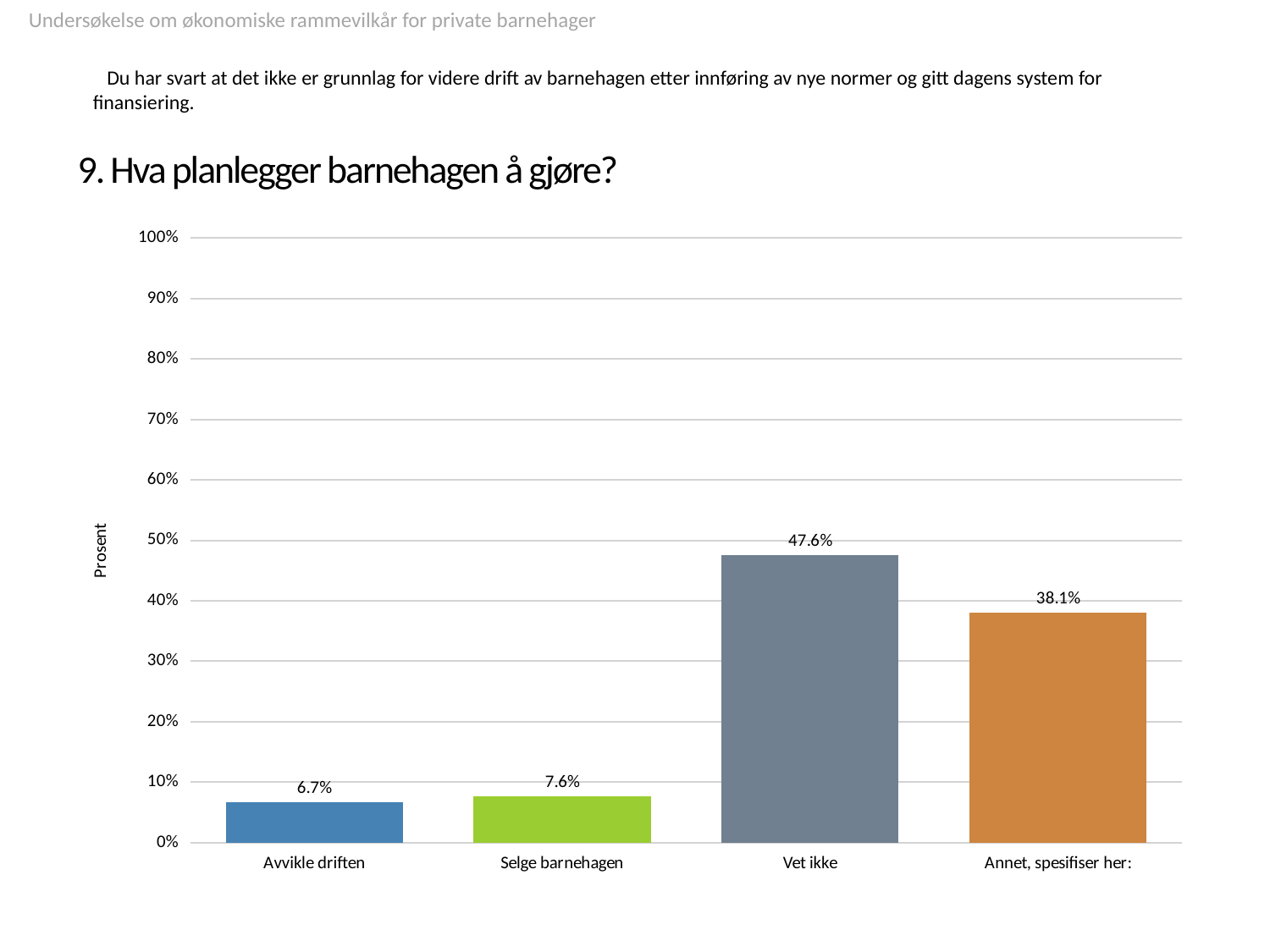
How many categories are shown on the x axis? 4 Which is larger, the value for "Selge barnehagen" or the value for "Avvikle driften"? Selge barnehagen What is the value for "Selge barnehagen"? 7.6% Is the value for "Annet, spesifiser her:" greater or less than 40%? less What is the label of the y axis? Prosent Which category has the highest value? Vet ikke What is the value for "Annet, spesifiser her:"? 38.1% What kind of chart is shown on the slide? bar chart Which category has the lowest value? Avvikle driften What is the difference between the values for "Vet ikke" and "Annet, spesifiser her:"? 9.5% What is the value for "Vet ikke"? 47.6% What is the value for "Avvikle driften"? 6.7%